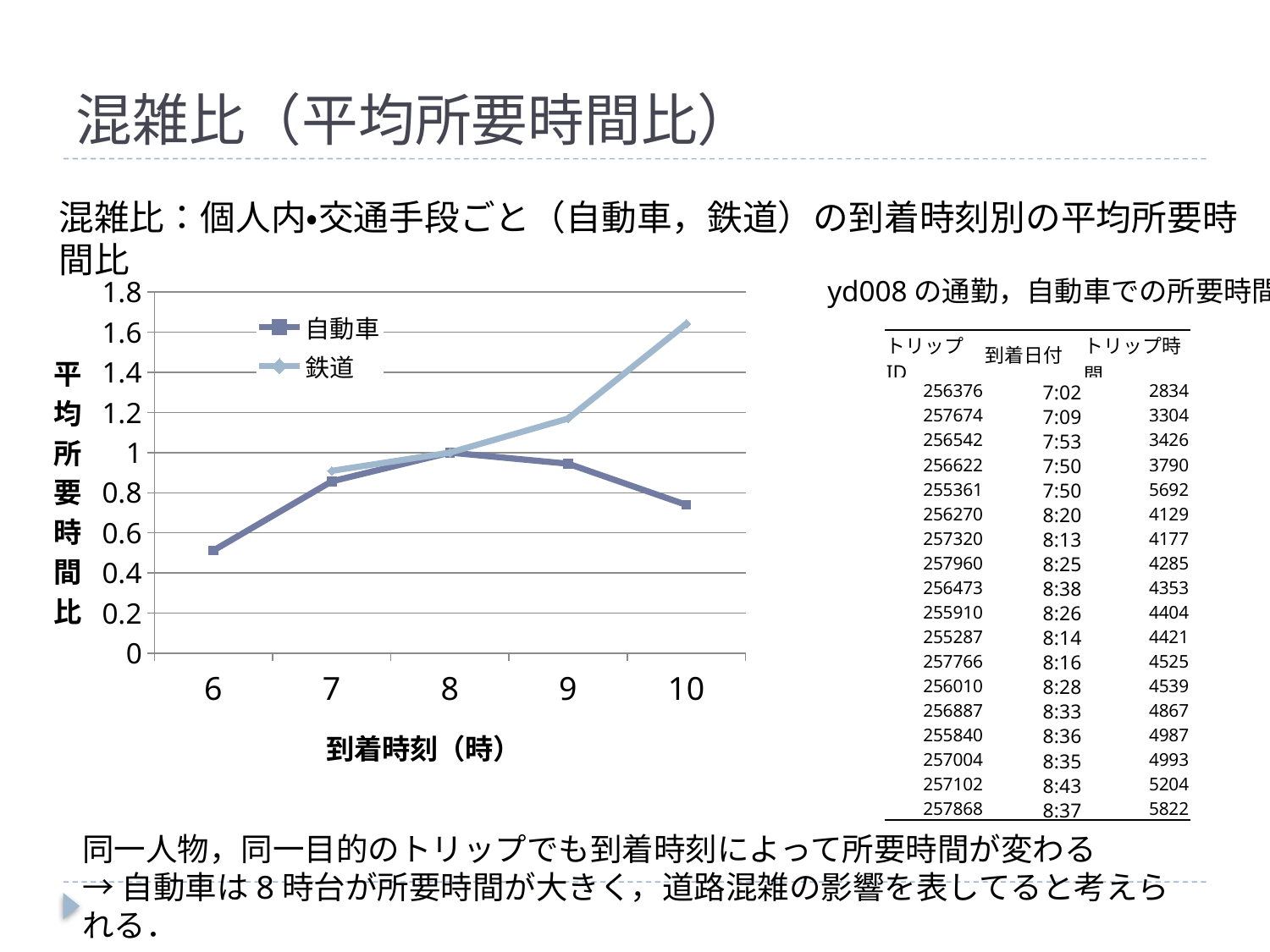
What is the value for 自動車 at arrival time 8? 1 How many series does the chart legend list? 2 Is the value for 鉄道 at arrival time 10 greater or less than 1.4? greater What is the value for 鉄道 at arrival time 8? 1 At arrival time 10, which series has the larger value, 自動車 or 鉄道? 鉄道 What kind of chart is shown on the slide? line chart Does the 鉄道 series rise or fall as arrival time increases from 7 to 10? rise How many arrival-time categories are shown on the x axis of the chart? 5 At which arrival time is the 鉄道 series highest? 10 At which arrival time is the 自動車 series lowest? 6 Is the value for 自動車 at arrival time 10 greater or less than 0.8? less Is the value for 自動車 at arrival time 6 greater or less than 0.6? less